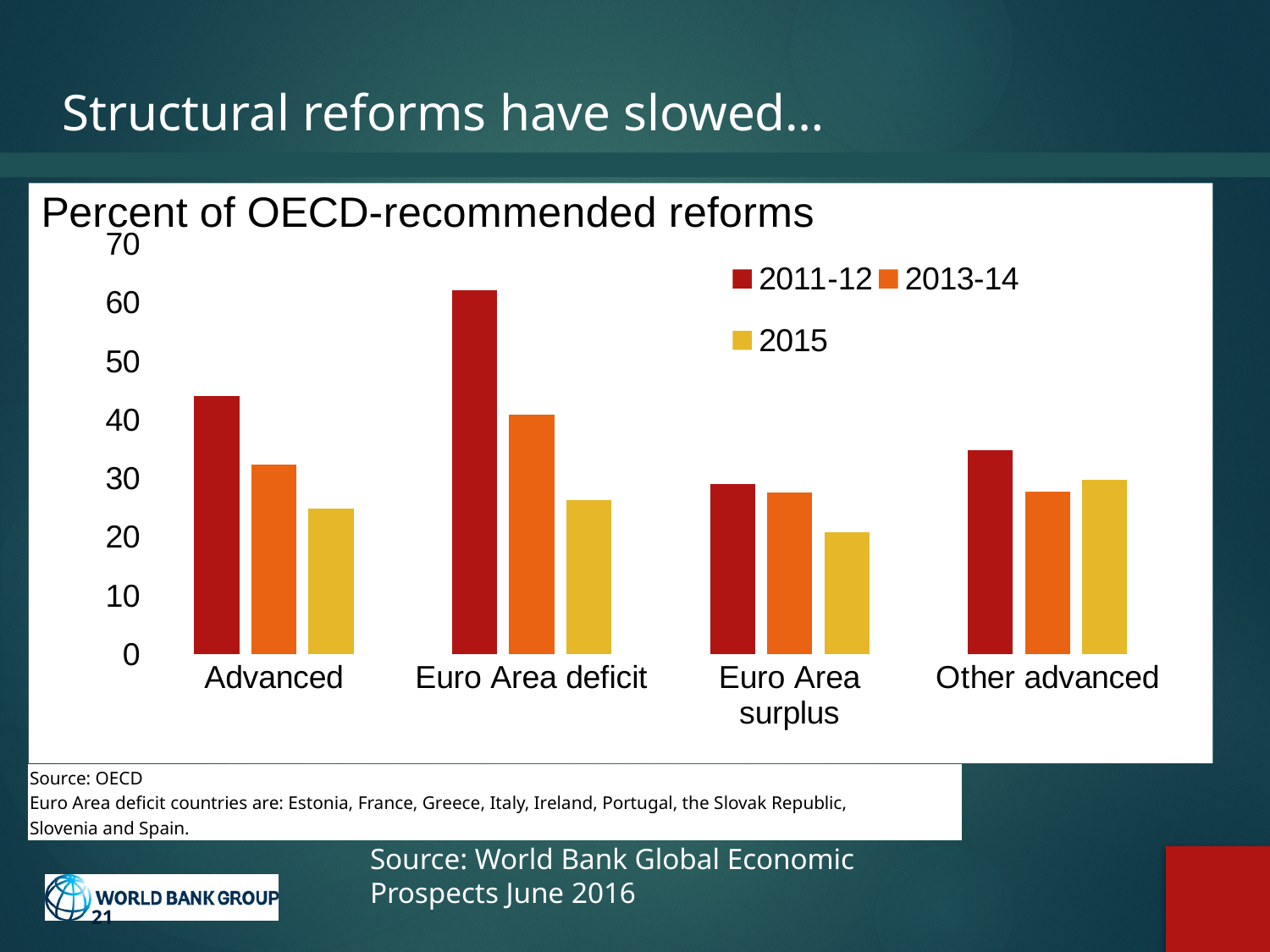
What is the title of the chart? Percent of OECD-recommended reforms Which is larger, the 2011-12 value for Advanced or the 2011-12 value for Other advanced? Advanced Which colour represents the 2015 series in the legend? Yellow Is the 2011-12 value for Euro Area deficit greater or less than 50? greater Is the 2011-12 value for Advanced greater or less than 40? greater For Euro Area deficit, do the values rise or fall from 2011-12 to 2015? fall Is the 2015 value for Euro Area surplus greater or less than 30? less How many series does the legend list? 3 Which country group has the lowest value for 2015? Euro Area surplus Which country group has the highest value for 2011-12? Euro Area deficit How many country groups are shown on the x axis? 4 What kind of chart is shown on the slide? Bar chart